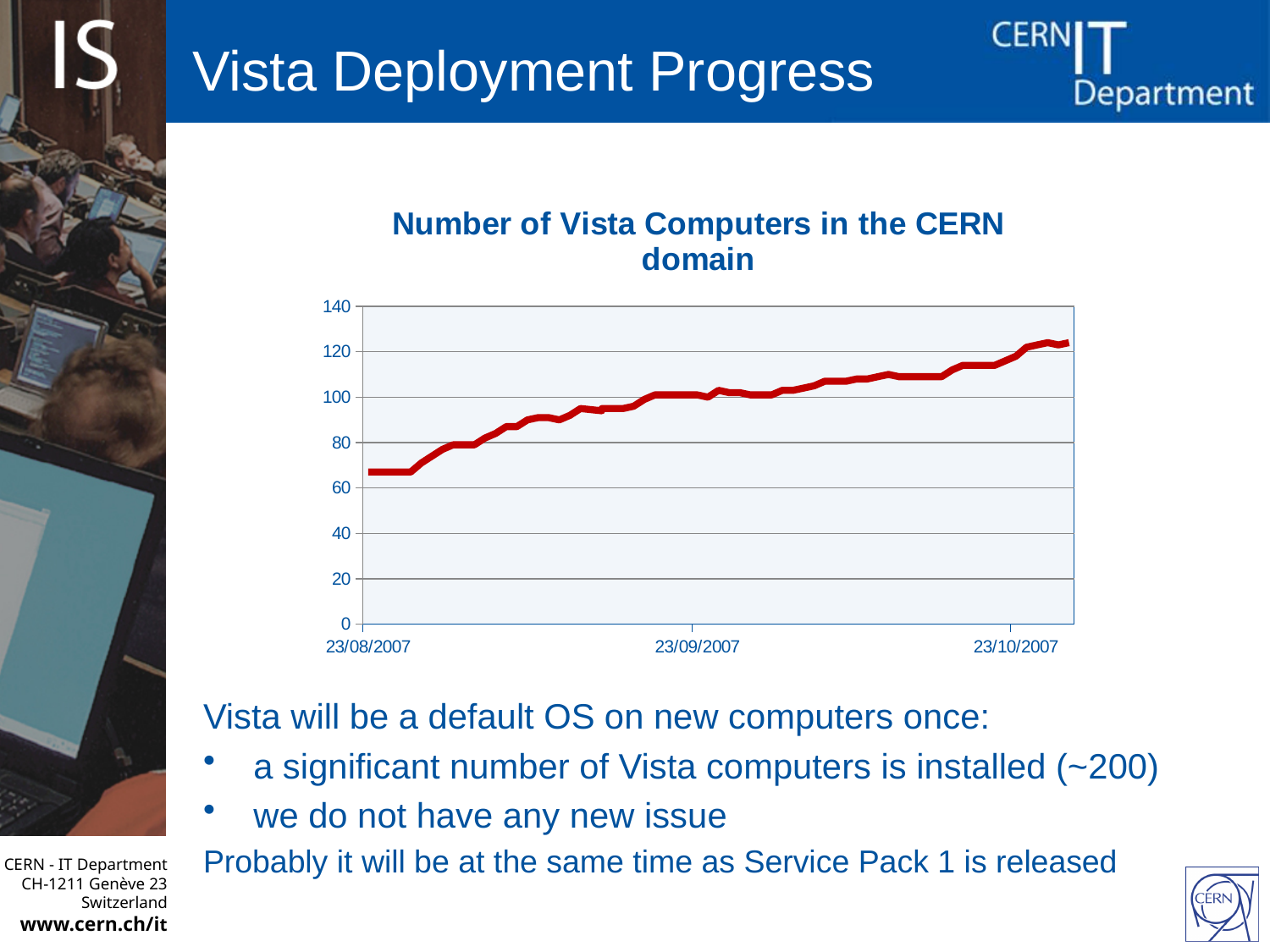
Is the value at 23/08/2007 greater or less than 80? less What is the highest value shown on the y axis of the chart? 140 Is the value at 23/09/2007 greater or less than 80? greater What kind of chart is shown on the slide? line chart Which is larger, the value at 23/08/2007 or the value at 23/10/2007? 23/10/2007 Is the last plotted value on the chart greater or less than 100? greater What is the title of the chart? Number of Vista Computers in the CERN domain Do the values in the chart rise or fall from 23/08/2007 to 23/10/2007? rise How many date labels are shown on the x axis of the chart? 3